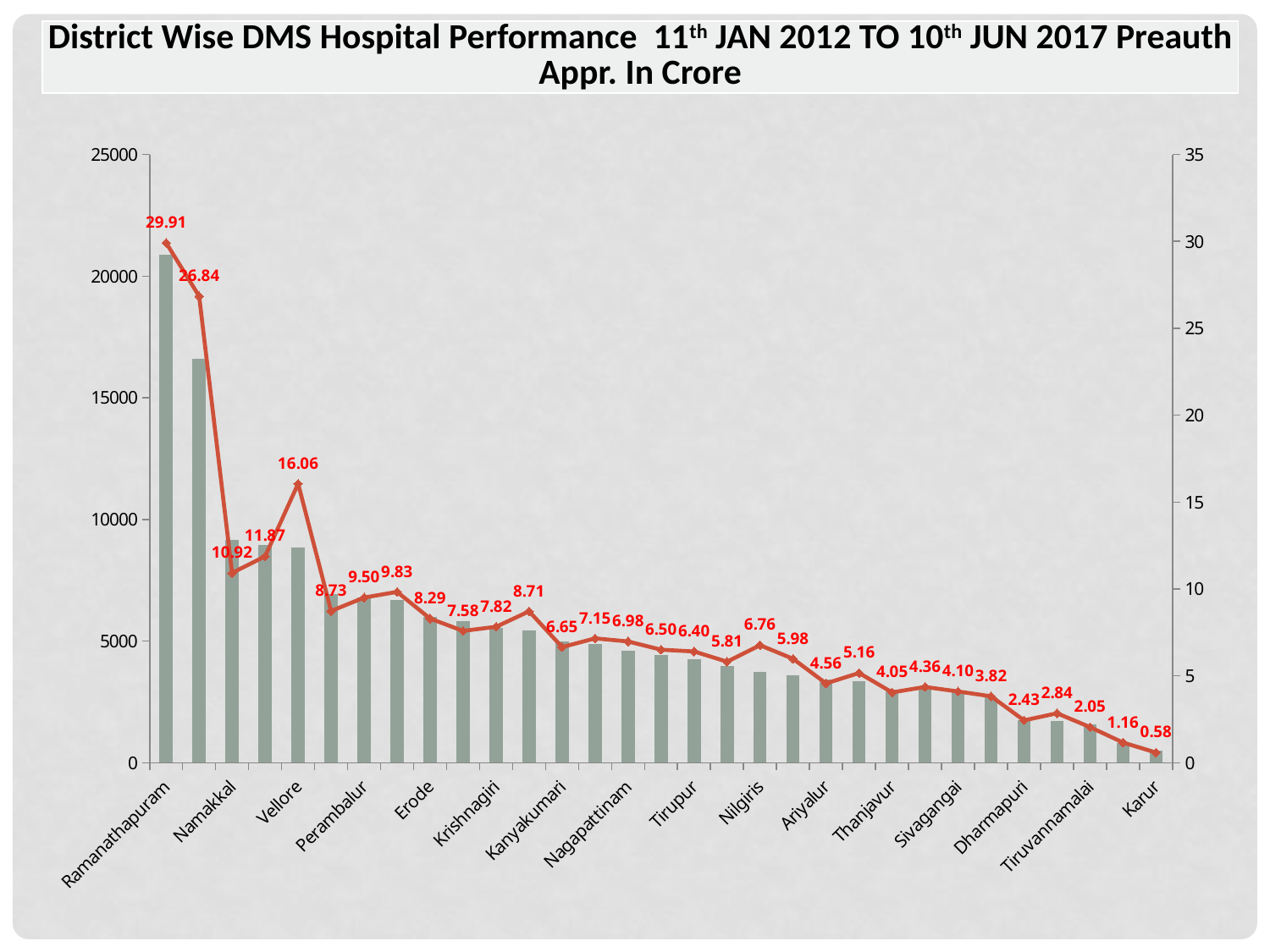
What value does the line show for Vellore? 16.06 Is the bar value for Ramanathapuram greater or less than 20000? greater Is the bar value for Vellore greater or less than 10000? less What value does the line show for Ramanathapuram? 29.91 What value does the line show for Karur? 0.58 Do the line values generally rise or fall from left to right across the districts? Fall What kind of chart is shown on the slide? Combination bar and line chart What is the difference between the line values for Vellore and Namakkal? 5.14 Which district has the lowest value on the line? Karur Which has the larger line value, Erode or Tirupur? Erode Which district has the highest value on the line? Ramanathapuram What value does the line show for Namakkal? 10.92